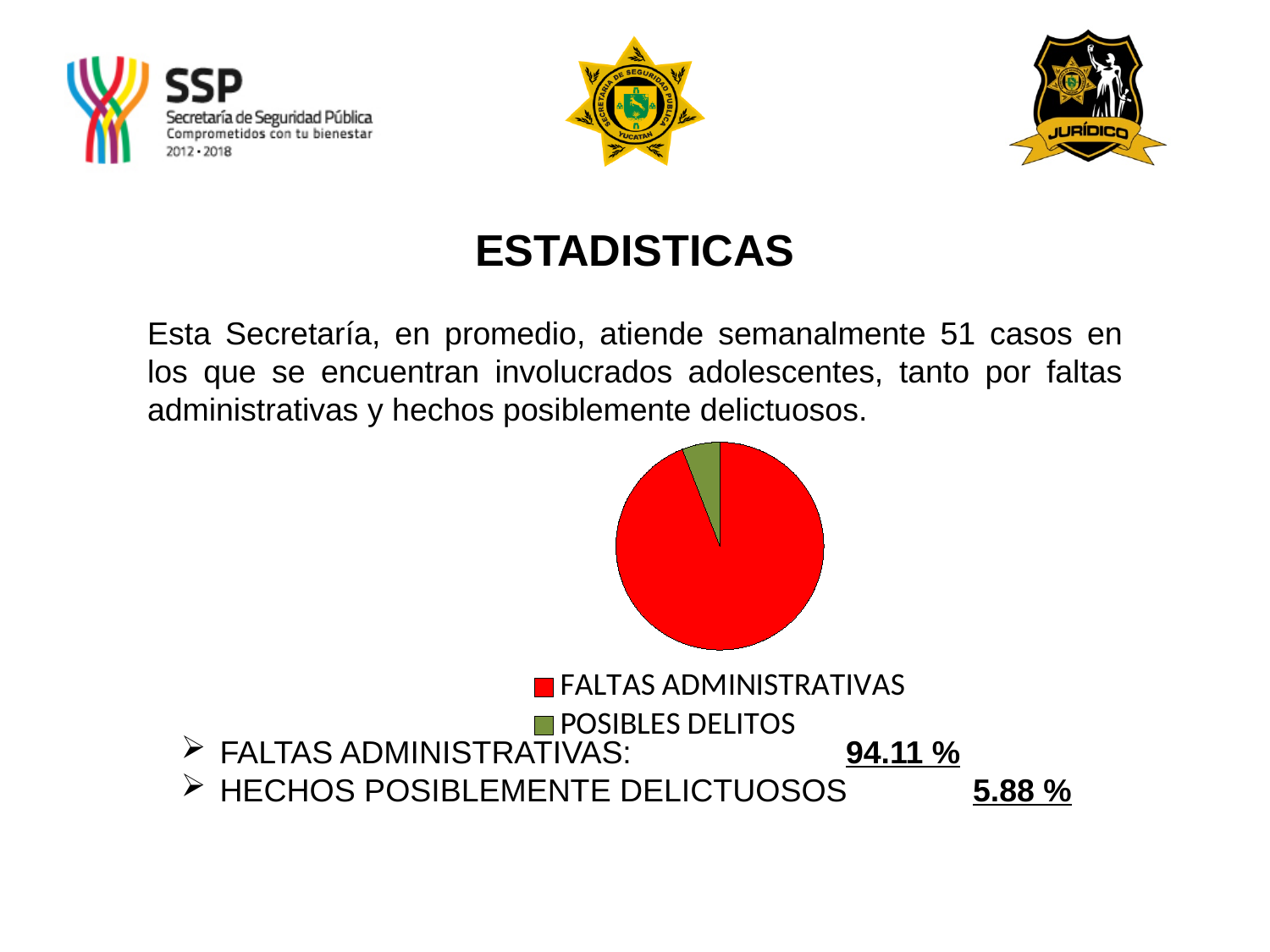
What kind of chart is shown on the slide? pie chart Is the share of FALTAS ADMINISTRATIVAS in the pie chart greater or less than 50%? greater Which is larger in the pie chart, FALTAS ADMINISTRATIVAS or POSIBLES DELITOS? FALTAS ADMINISTRATIVAS What colour is the FALTAS ADMINISTRATIVAS slice in the pie chart? red Is the share of POSIBLES DELITOS in the pie chart greater or less than 25%? less Which category takes the largest share of the pie chart? FALTAS ADMINISTRATIVAS How many entries does the legend of the pie chart list? 2 According to the slide, what share of cases are HECHOS POSIBLEMENTE DELICTUOSOS? 5.88 % According to the slide, what share of cases are FALTAS ADMINISTRATIVAS? 94.11 % Which category takes the smallest share of the pie chart? POSIBLES DELITOS How many slices does the pie chart have? 2 What colour is the POSIBLES DELITOS slice in the pie chart? green